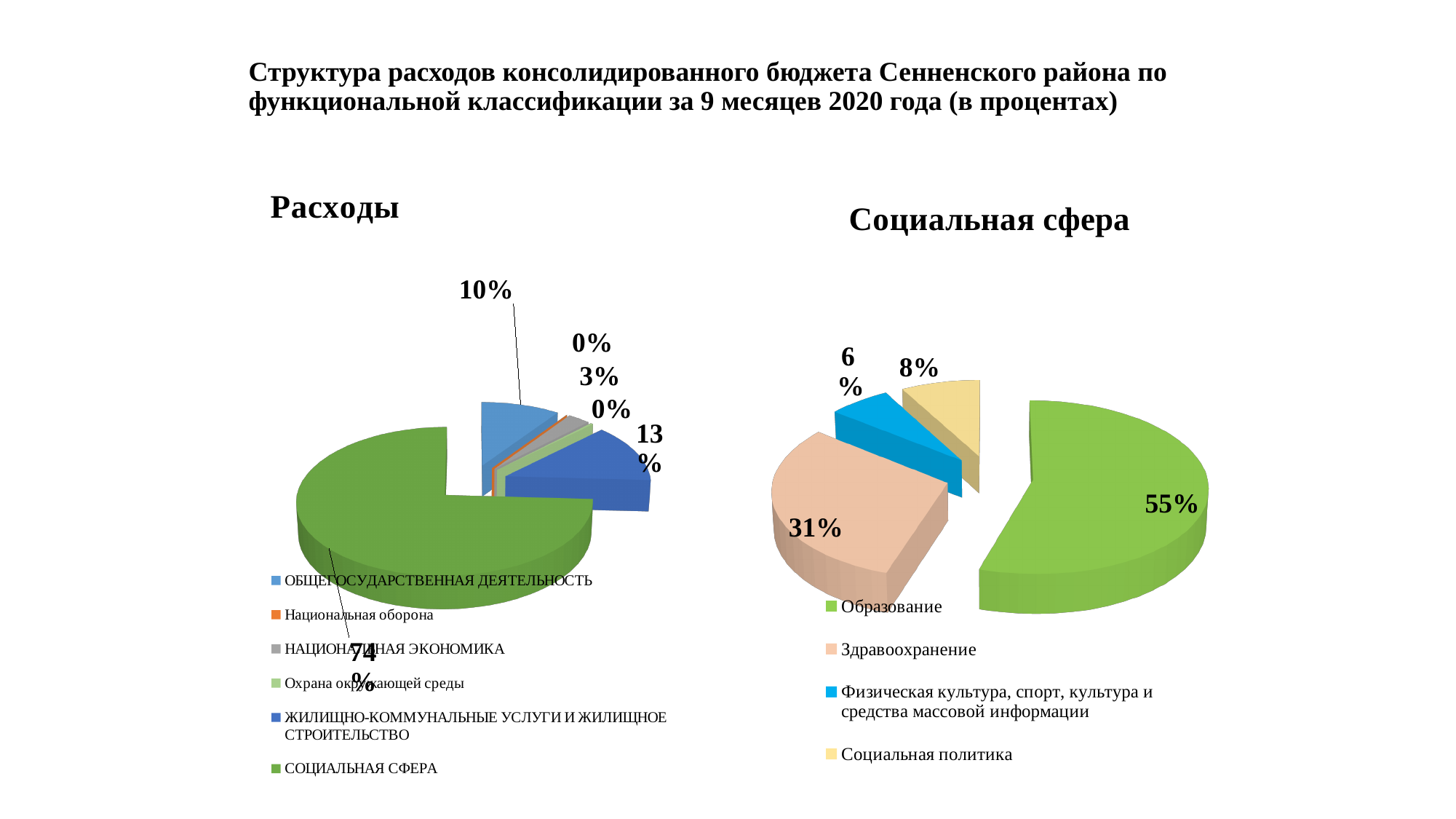
In the 'Социальная сфера' chart, which category has the smallest share? Физическая культура, спорт, культура и средства массовой информации In the 'Расходы' chart, what share is labelled for ОБЩЕГОСУДАРСТВЕННАЯ ДЕЯТЕЛЬНОСТЬ? 10% In the 'Расходы' chart, what share is labelled for ЖИЛИЩНО-КОММУНАЛЬНЫЕ УСЛУГИ И ЖИЛИЩНОЕ СТРОИТЕЛЬСТВО? 13% What kind of chart is the 'Расходы' chart? Pie chart In the 'Расходы' chart, what share is labelled for СОЦИАЛЬНАЯ СФЕРА? 74% In the 'Социальная сфера' chart, how many categories does the legend list? 4 In the 'Расходы' chart, which category has the largest share? СОЦИАЛЬНАЯ СФЕРА In the 'Социальная сфера' chart, what share is labelled for Здравоохранение? 31% In the 'Социальная сфера' chart, what is the difference in percentage points between Образование and Здравоохранение? 24 In the 'Расходы' chart, how many categories does the legend list? 6 In the 'Социальная сфера' chart, what share is labelled for Образование? 55% In the 'Социальная сфера' chart, what share is labelled for Социальная политика? 8%